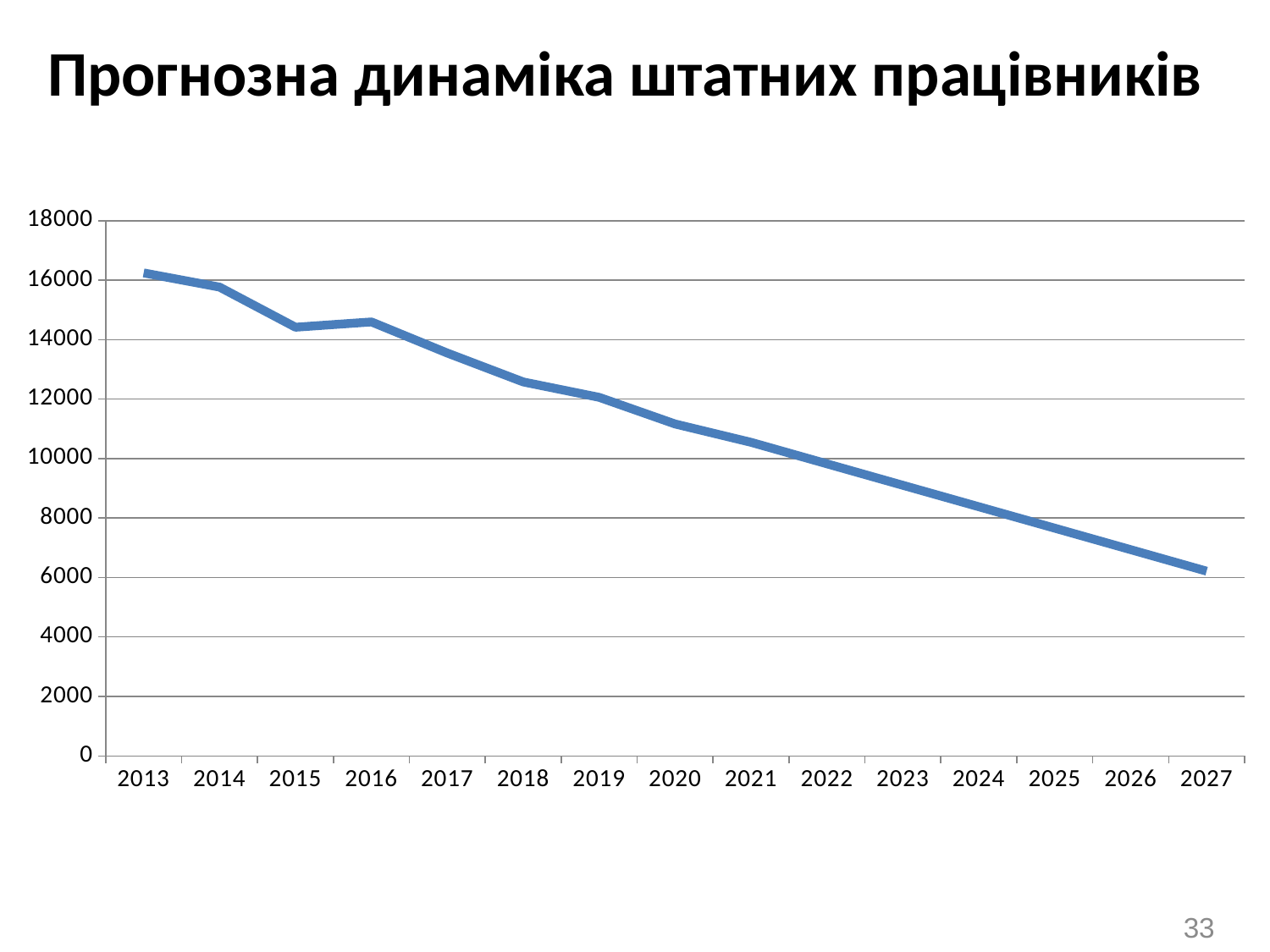
Which year has the larger value, 2024 or 2020? 2020 Is the value for 2027 greater or less than 8000? less Which year has the highest value on the chart? 2013 Which year has the larger value, 2016 or 2018? 2016 What kind of chart is shown on the slide? line chart What is the title of the chart on the slide? Прогнозна динаміка штатних працівників Is the value for 2013 greater or less than 16000? greater Which year has the lowest value on the chart? 2027 How many years are plotted along the x axis of the chart? 15 Do the values generally rise or fall from 2013 to 2027? fall